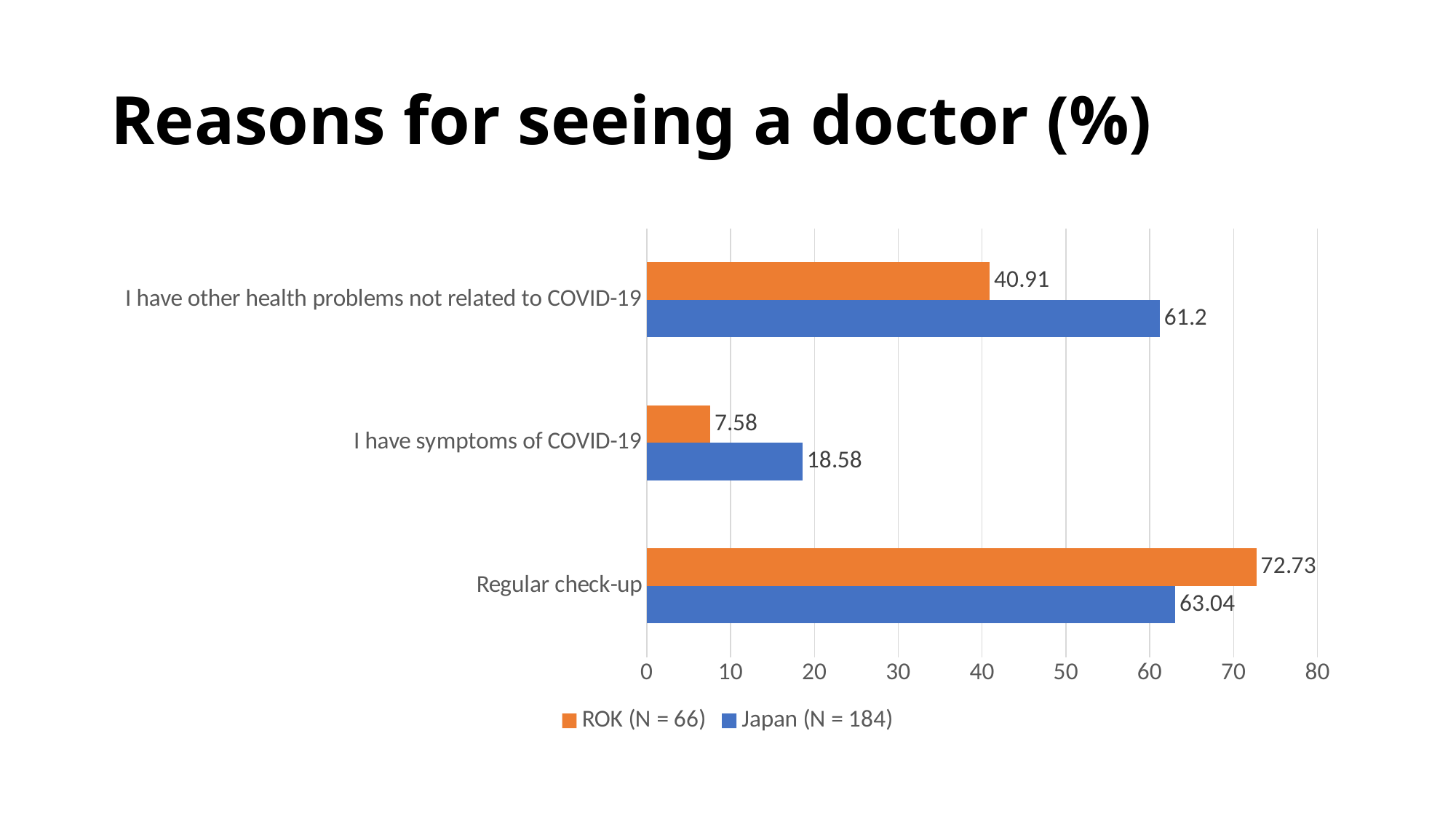
Which category has the highest value for ROK (N = 66)? Regular check-up What is the value for Japan (N = 184) for 'I have other health problems not related to COVID-19'? 61.2 What is the title of the chart? Reasons for seeing a doctor (%) Which category has the lowest value for Japan (N = 184)? I have symptoms of COVID-19 How many series does the legend list? 2 What is the value for Japan (N = 184) for 'I have symptoms of COVID-19'? 18.58 For 'I have other health problems not related to COVID-19', which series has the larger value, ROK (N = 66) or Japan (N = 184)? Japan (N = 184) What is the value for ROK (N = 66) for 'Regular check-up'? 72.73 How many categories are shown on the chart? 3 Is the value for ROK (N = 66) for 'I have symptoms of COVID-19' greater or less than 10? less What is the difference between the ROK (N = 66) and Japan (N = 184) values for 'Regular check-up'? 9.69 What kind of chart is shown on the slide? Bar chart